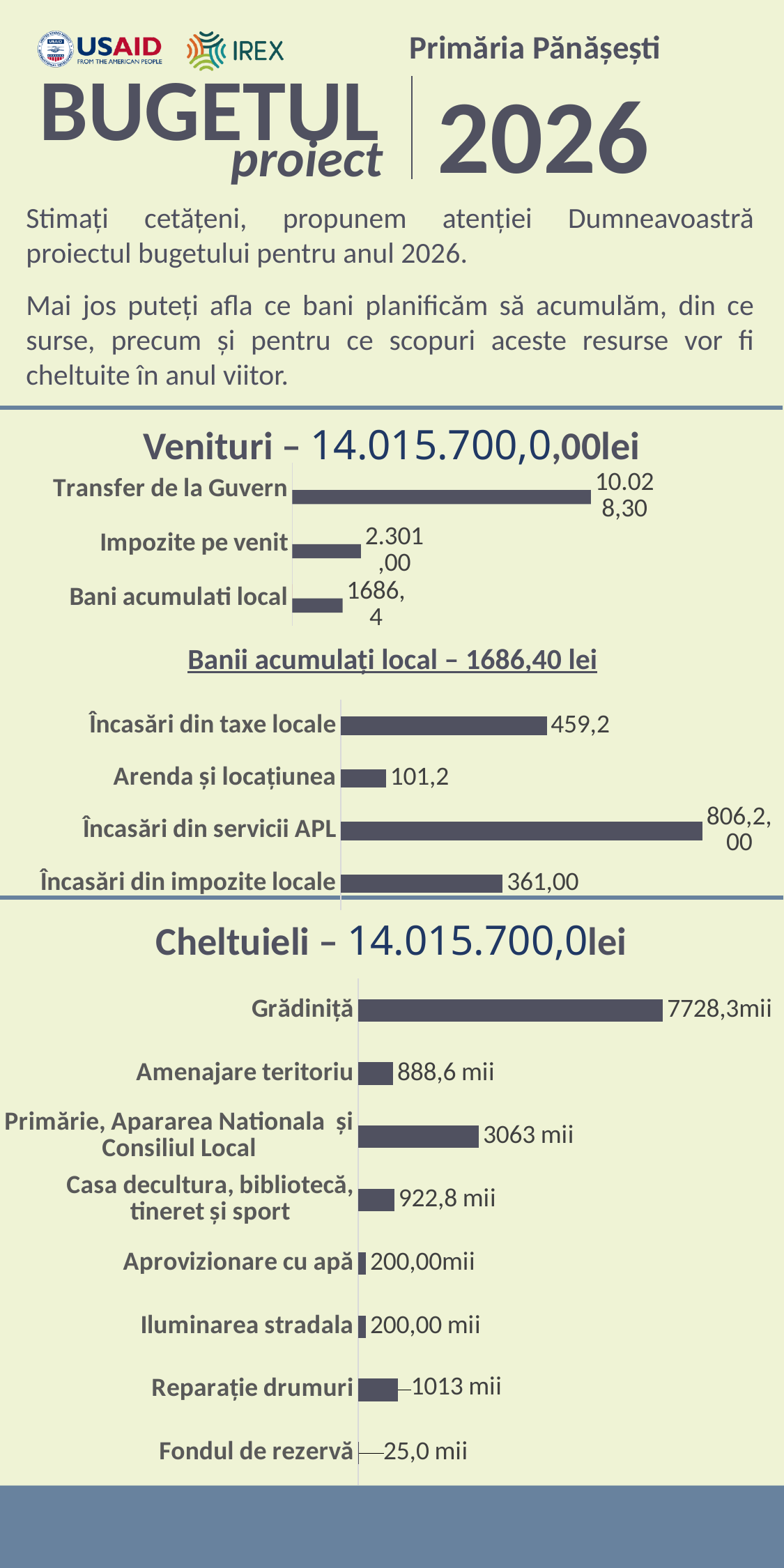
In the 'Venituri' chart, what is the value for Transfer de la Guvern? 10.028,30 What is the total shown in the title of the 'Cheltuieli' chart? 14.015.700,0lei In the 'Cheltuieli' chart, what is the value for Grădiniță? 7728,3mii In the 'Banii acumulați local' chart, what is the value for Arenda și locațiunea? 101,2 In the 'Banii acumulați local' chart, which is larger: Încasări din taxe locale or Încasări din impozite locale? Încasări din taxe locale In the 'Venituri' chart, which category has the lowest value? Bani acumulati local What kind of chart is the 'Cheltuieli' chart? Bar chart In the 'Venituri' chart, how many categories are shown? 3 In the 'Cheltuieli' chart, how many categories are shown? 8 In the 'Banii acumulați local' chart, which category has the highest value? Încasări din servicii APL In the 'Cheltuieli' chart, which category has the lowest value? Fondul de rezervă In the 'Banii acumulați local' chart, what is the difference between Încasări din taxe locale and Arenda și locațiunea? 358,0